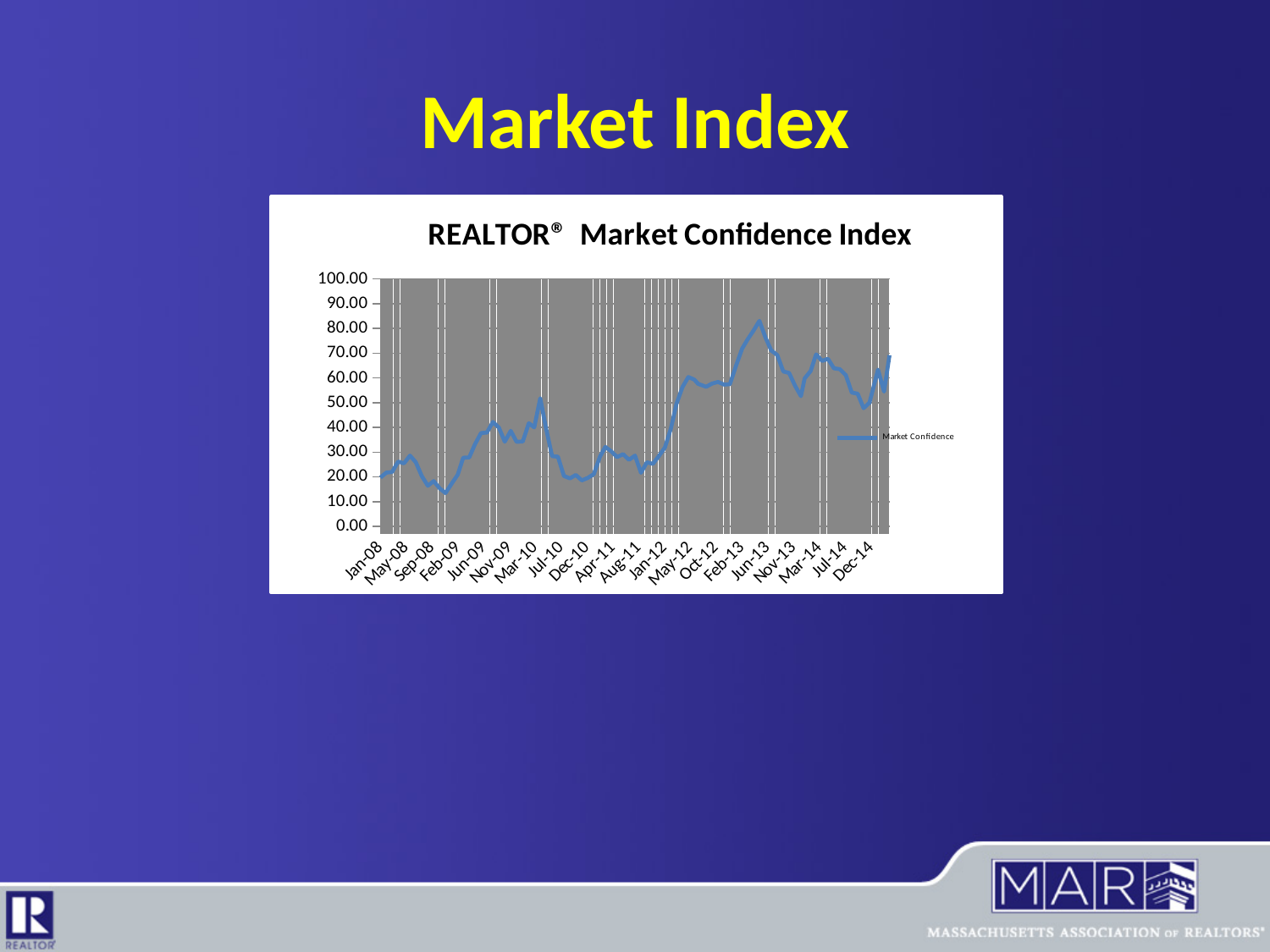
Is the value for Market Confidence at Dec-14 greater or less than 60.00? less How many series does the legend list? 1 Is the value for Market Confidence at Jun-13 greater or less than 70.00? greater What kind of chart is shown on the slide? line chart Overall, does the Market Confidence line rise or fall from Jan-08 to Dec-14? rise What is the title of the chart? REALTOR® Market Confidence Index Around which x-axis label does the Market Confidence line reach its highest point? Jun-13 Is the value for Market Confidence at Oct-12 greater or less than 50.00? greater Around which x-axis label does the Market Confidence line reach its lowest point? Feb-09 What is the name of the series shown in the legend? Market Confidence